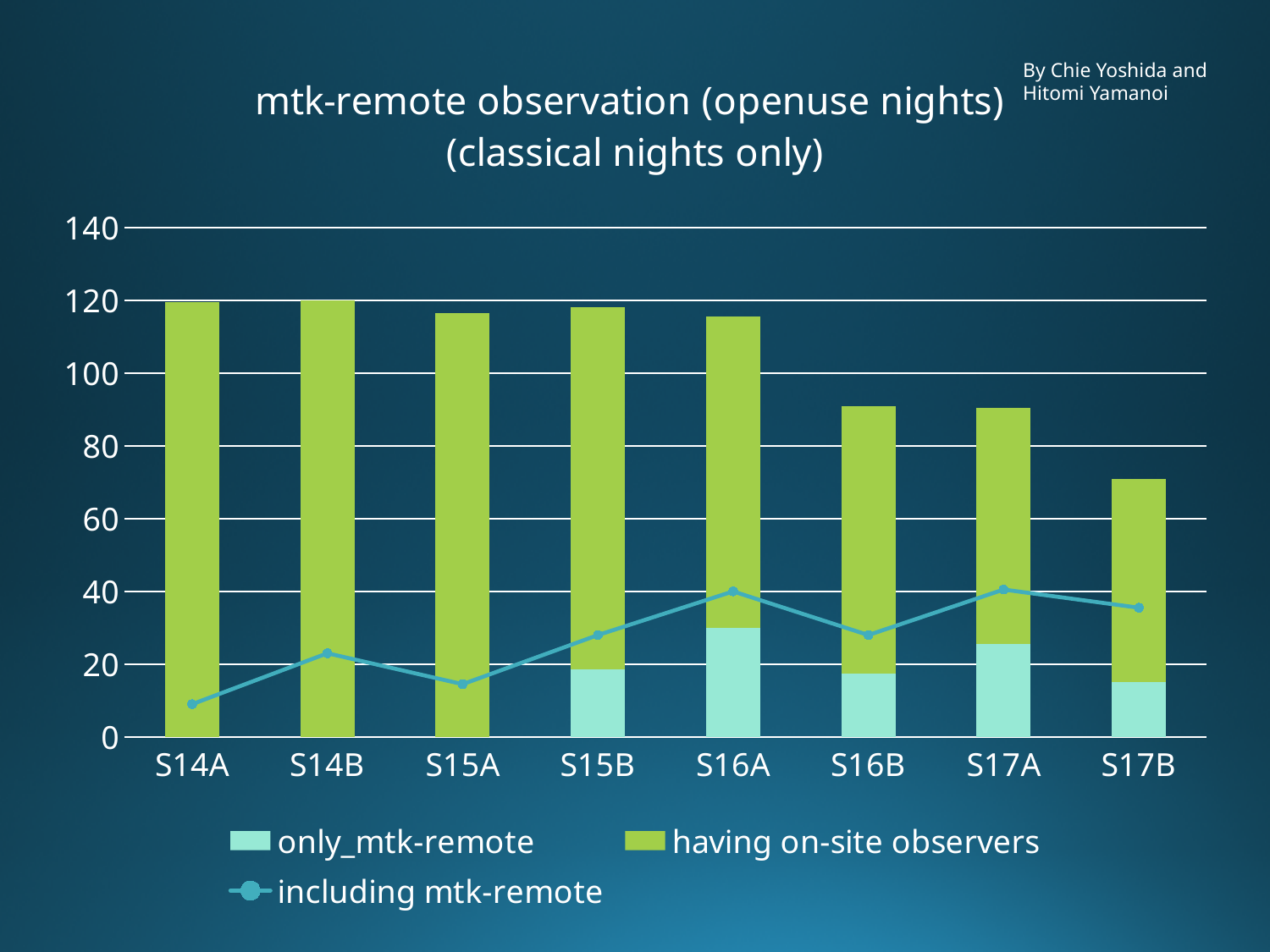
Which category has the lowest total bar height? S17B How many categories are shown on the x axis? 8 Is the 'including mtk-remote' value for S14A greater or less than 20? less What kind of chart is this? A stacked bar chart with a line series How many series does the legend list? 3 Is the total bar height for S16B greater or less than 80? greater Is the total bar height for S17B greater or less than 80? less Which category has the lowest value for the 'including mtk-remote' line? S14A Which has the larger total bar height, S16B or S17B? S16B Which has the larger 'including mtk-remote' value, S14A or S14B? S14B Do the total bar heights generally rise or fall from S14A to S17B? fall